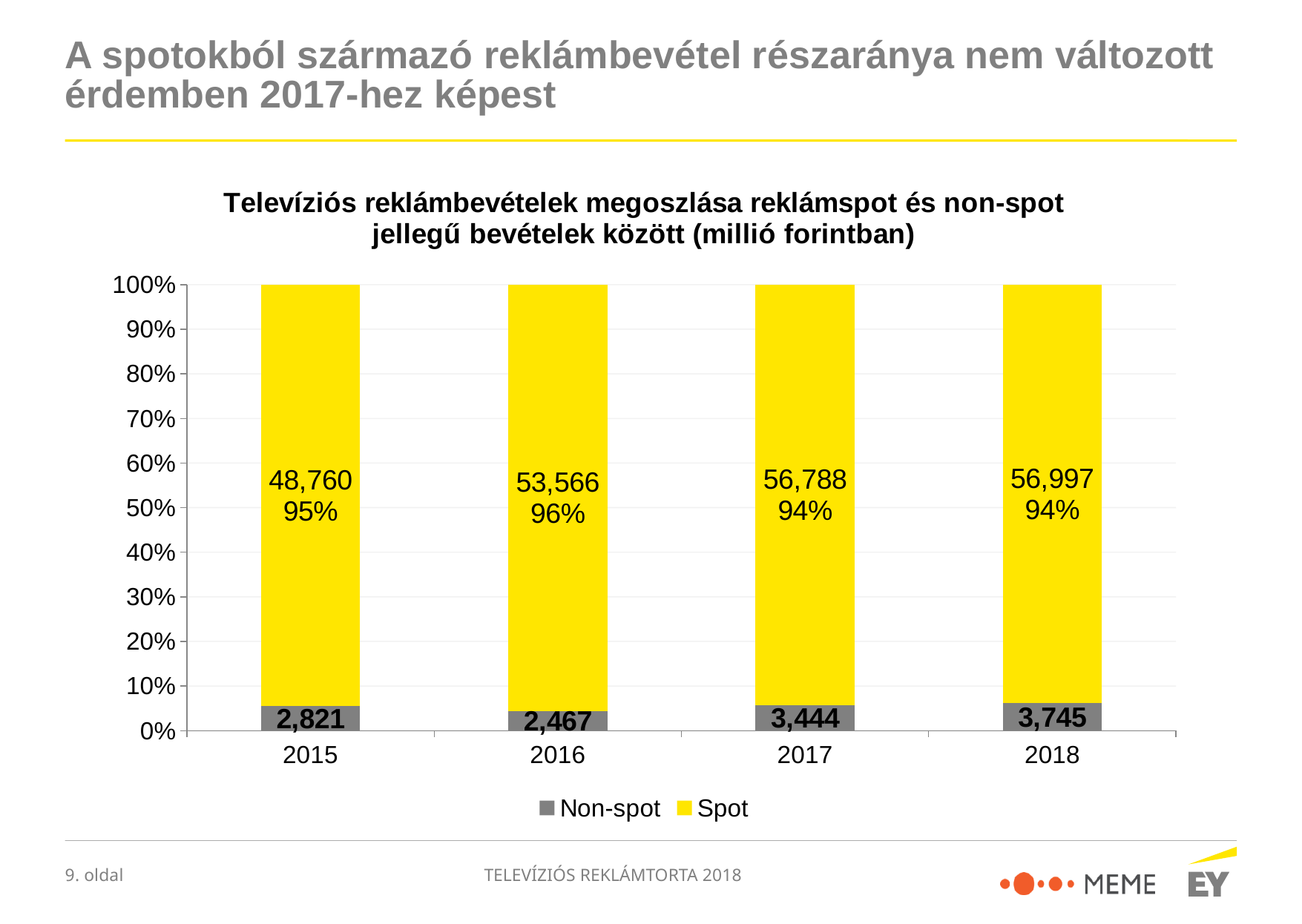
What percentage share does Spot have in 2016? 96% What is the difference between the Spot values for 2018 and 2017? 209 Which year has the highest Non-spot value? 2018 Which year has the lowest Spot value? 2015 Which is larger, the Non-spot value for 2015 or for 2016? 2015 What is the total of the 2017 bar (Spot plus Non-spot)? 60,232 Which year has the lowest Non-spot value? 2016 How many series does the legend list? 2 What is the Non-spot value for 2018? 3,745 What is the Spot value for 2015? 48,760 What is the Spot value for 2016? 53,566 What is the difference between the Non-spot values for 2018 and 2017? 301